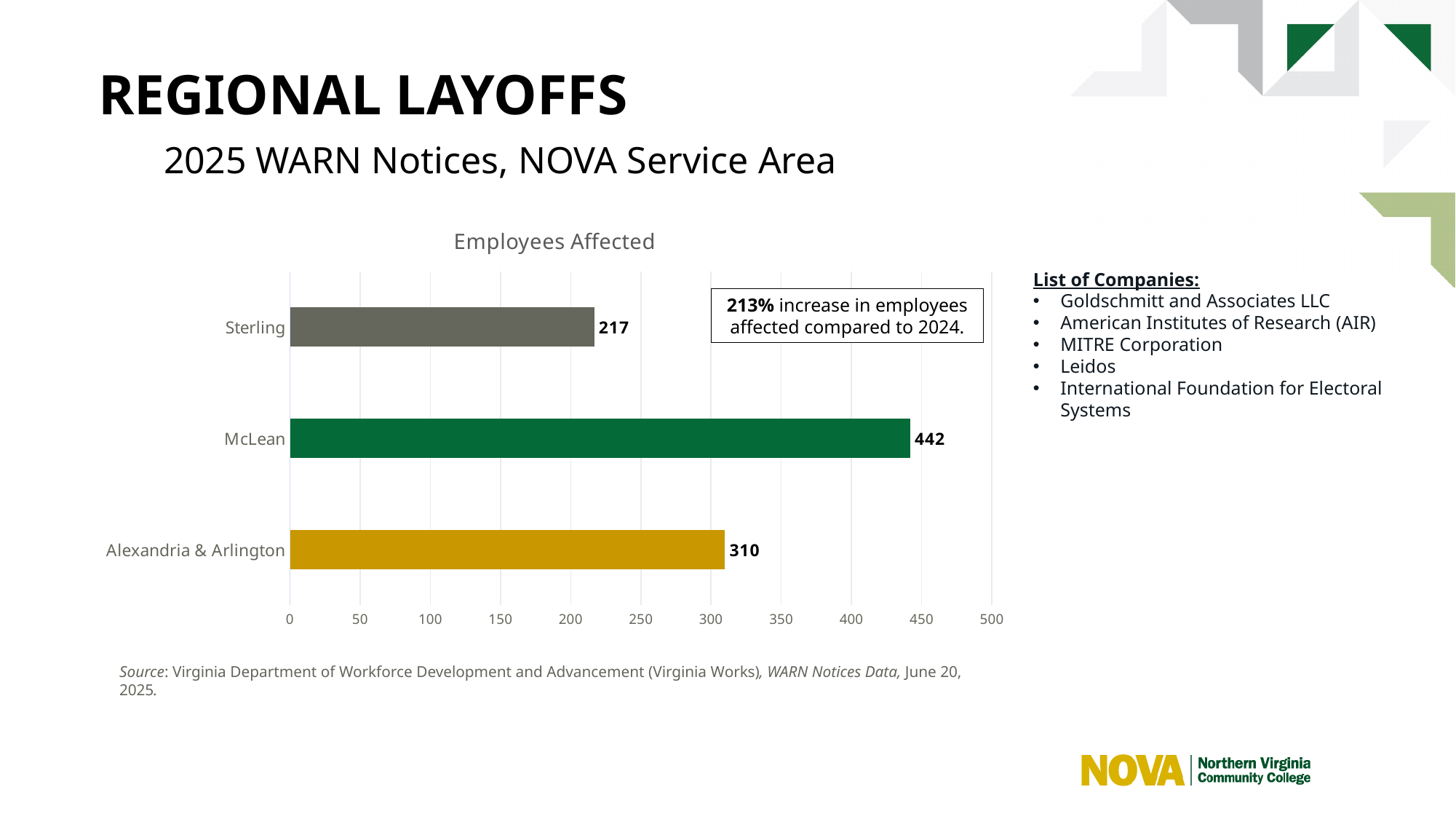
What kind of chart is shown on the slide? Bar chart Which area has the highest number of employees affected? McLean How many areas are shown in the chart? 3 What is the difference in employees affected between Alexandria & Arlington and Sterling? 93 Which has more employees affected, Alexandria & Arlington or Sterling? Alexandria & Arlington How many employees were affected in Alexandria & Arlington? 310 Which area has the lowest number of employees affected? Sterling How many employees were affected in McLean? 442 What is the difference in employees affected between McLean and Sterling? 225 What is the title of the chart? Employees Affected Is the value for McLean greater or less than 400? greater How many employees were affected in Sterling? 217